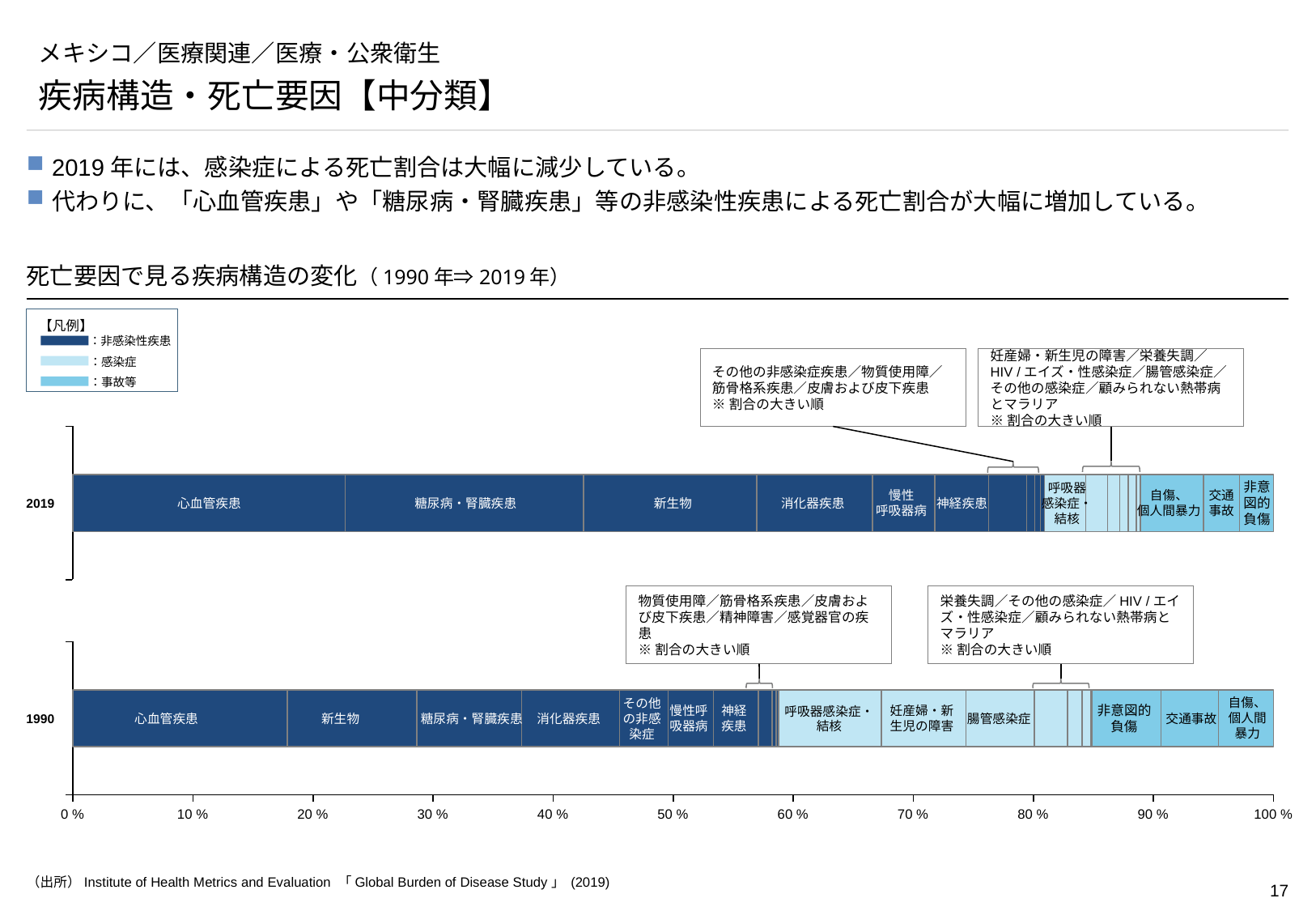
Is the share of 新生物 in 2019 greater or less than 10%? greater Which cause of death has the largest share in the 2019 bar? 心血管疾患 Which cause of death has the largest share in the 1990 bar? 心血管疾患 In the 2019 bar, which has the larger share: 糖尿病・腎臓疾患 or 新生物? 糖尿病・腎臓疾患 Is the share of 心血管疾患 in 2019 greater or less than 20%? greater What kind of chart is shown on the slide? Stacked bar chart What is the title of the chart? 死亡要因で見る疾病構造の変化（1990年⇒2019年） Is the share of 心血管疾患 in 1990 greater or less than 20%? less Which year has the larger share for 呼吸器感染症・結核, 1990 or 2019? 1990 According to the legend, which category is shown in the darkest blue? 非感染性疾患 How many bars (years) does the chart show? 2 How many categories does the legend (凡例) list? 3